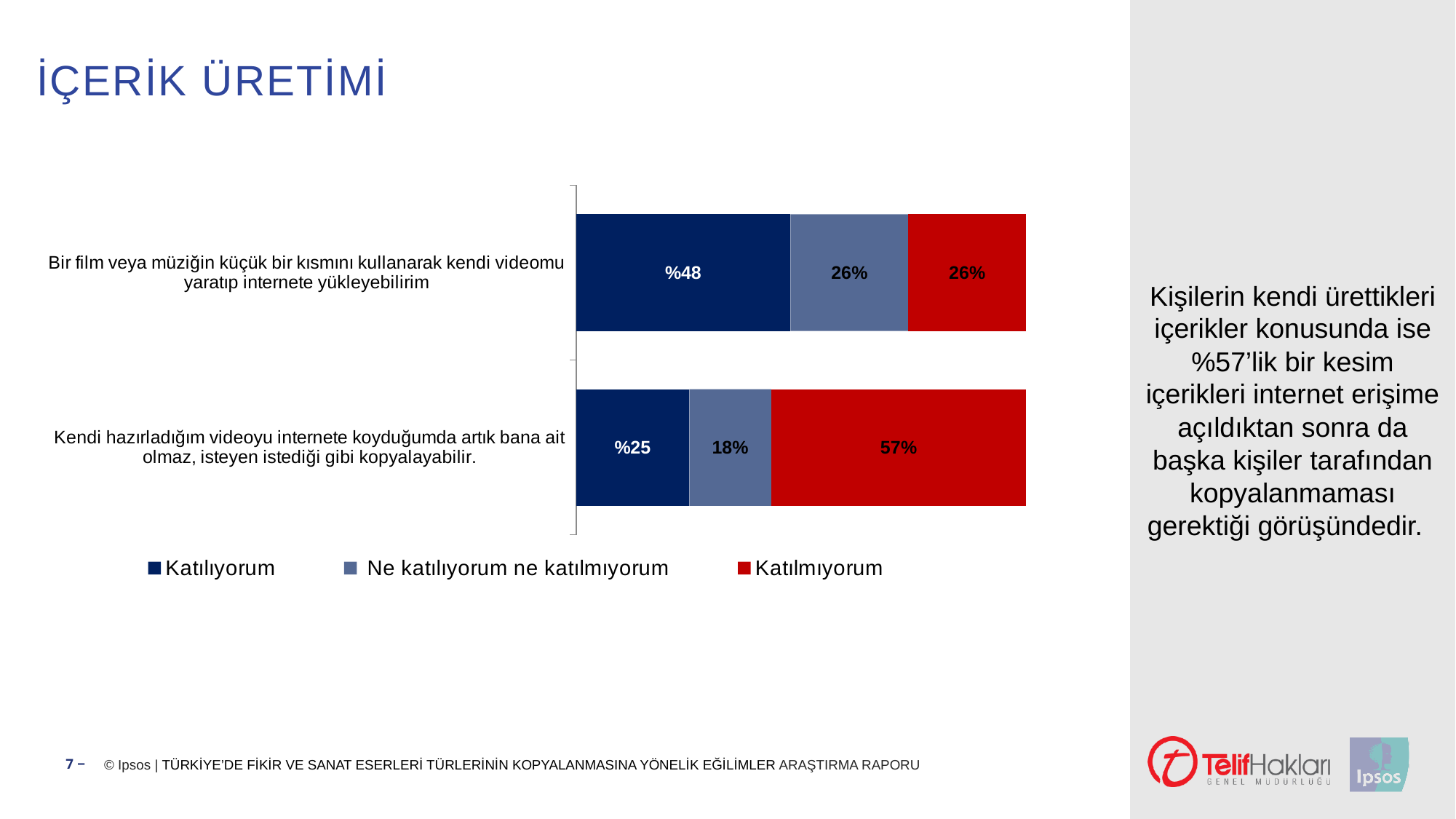
What is the difference between the 'Katılıyorum' values of the two statements? 23 percentage points Which statement has the higher 'Katılıyorum' share? Bir film veya müziğin küçük bir kısmını kullanarak kendi videomu yaratıp internete yükleyebilirim What is the 'Katılmıyorum' value for the statement 'Kendi hazırladığım videoyu internete koyduğumda artık bana ait olmaz, isteyen istediği gibi kopyalayabilir.'? 57% What is the 'Ne katılıyorum ne katılmıyorum' value for the statement 'Kendi hazırladığım videoyu internete koyduğumda artık bana ait olmaz, isteyen istediği gibi kopyalayabilir.'? 18% What is the 'Katılmıyorum' value for the statement 'Bir film veya müziğin küçük bir kısmını kullanarak kendi videomu yaratıp internete yükleyebilirim'? 26% Which statement has the lower 'Katılmıyorum' share? Bir film veya müziğin küçük bir kısmını kullanarak kendi videomu yaratıp internete yükleyebilirim How many statements (categories) are plotted in the chart? 2 Which colour represents 'Katılmıyorum' in the chart? Red How many series does the legend list? 3 Is the 'Katılıyorum' value larger for the first statement or the second statement? The first statement What is the 'Katılıyorum' value for the statement 'Bir film veya müziğin küçük bir kısmını kullanarak kendi videomu yaratıp internete yükleyebilirim'? %48 What kind of chart is shown on the slide? Stacked bar chart